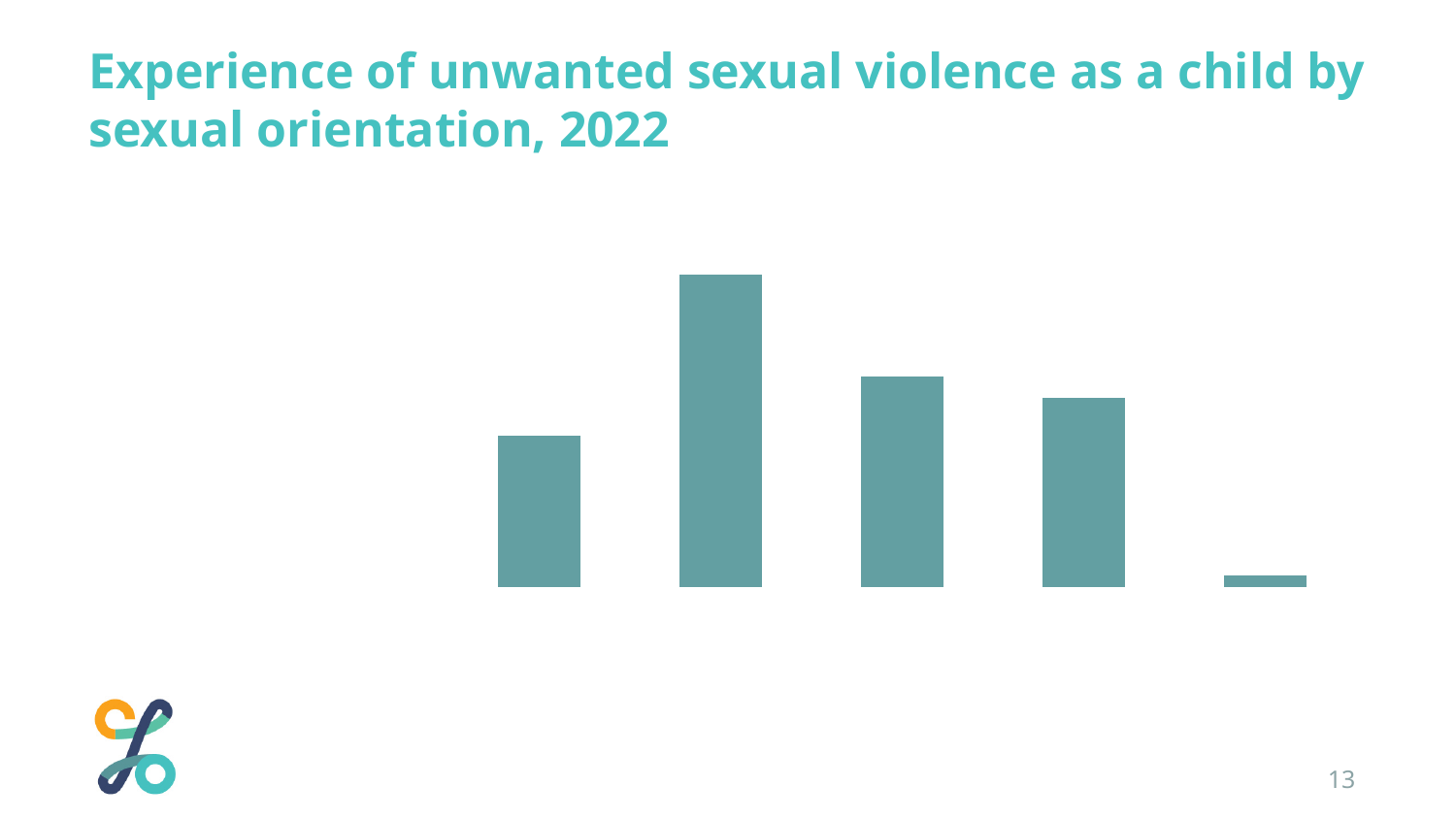
Which bar, counted from the left, is the tallest? the second bar What is the title of the chart on the slide? Experience of unwanted sexual violence as a child by sexual orientation, 2022 Which bar, counted from the left, is the shortest? the fifth bar What kind of chart is shown on the slide? bar chart Which is taller, the first bar from the left or the fifth bar from the left? the first bar Which is taller, the third bar from the left or the fourth bar from the left? the third bar Do the bar heights rise or fall from the second bar to the fifth bar? fall Which is taller, the first bar from the left or the third bar from the left? the third bar What colour are the bars in the chart? teal How many bars does the chart show? 5